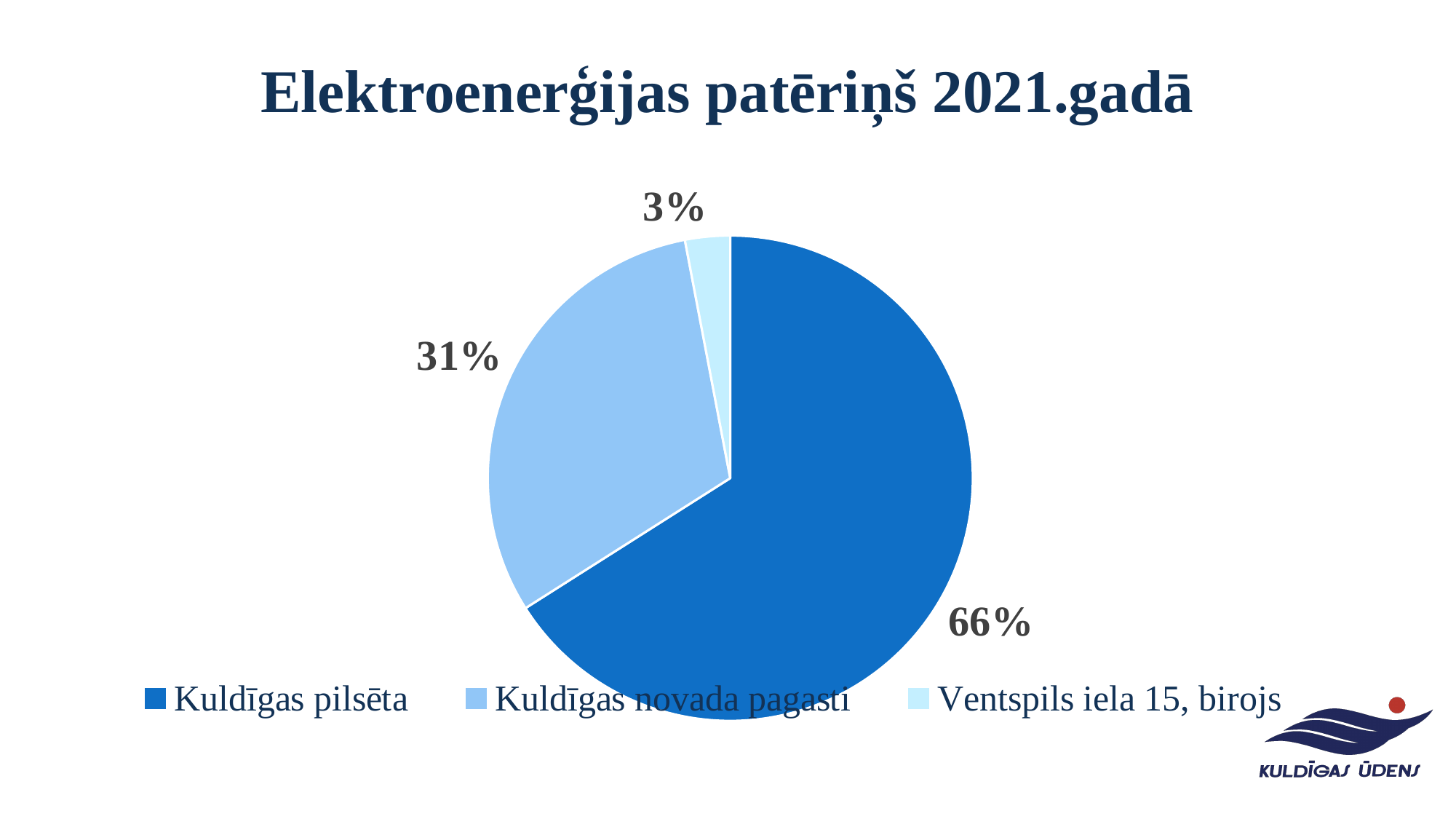
What share of the pie does Ventspils iela 15, birojs have? 3% What is the title of the slide? Elektroenerģijas patēriņš 2021.gadā What kind of chart is shown on the slide? pie chart How many slices does the pie chart have? 3 Which category has the largest slice of the pie? Kuldīgas pilsēta How many entries does the legend list? 3 What share of the pie does Kuldīgas novada pagasti have? 31% What is the difference in percentage points between Kuldīgas pilsēta and Kuldīgas novada pagasti? 35 What share of the pie does Kuldīgas pilsēta have? 66% Which legend entry is shown in the darkest blue colour? Kuldīgas pilsēta Which is larger, the share for Kuldīgas novada pagasti or the share for Ventspils iela 15, birojs? Kuldīgas novada pagasti Which category has the smallest slice of the pie? Ventspils iela 15, birojs